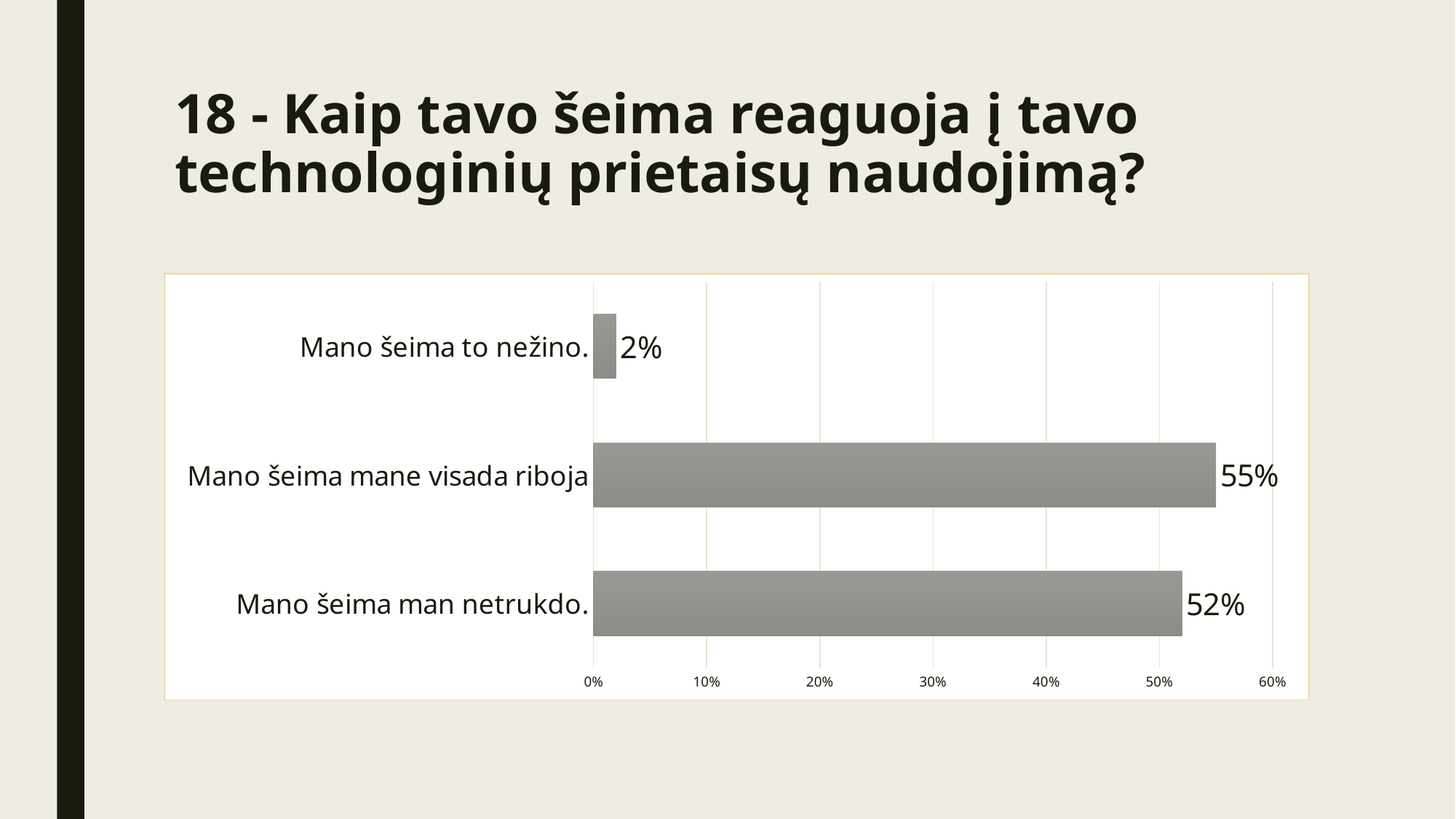
How many categories are shown in the chart? 3 What kind of chart is shown on the slide? bar chart What is the difference between the values for "Mano šeima mane visada riboja" and "Mano šeima man netrukdo."? 3% Which is larger: the value for "Mano šeima man netrukdo." or the value for "Mano šeima to nežino."? Mano šeima man netrukdo. Which category has the highest value? Mano šeima mane visada riboja Which category has the lowest value? Mano šeima to nežino. Is the value for "Mano šeima man netrukdo." greater or less than 50%? greater What is the difference between the values for "Mano šeima man netrukdo." and "Mano šeima to nežino."? 50% What is the value for "Mano šeima to nežino."? 2% What is the maximum value shown on the horizontal axis? 60% What is the value for "Mano šeima mane visada riboja"? 55% What is the value for "Mano šeima man netrukdo."? 52%